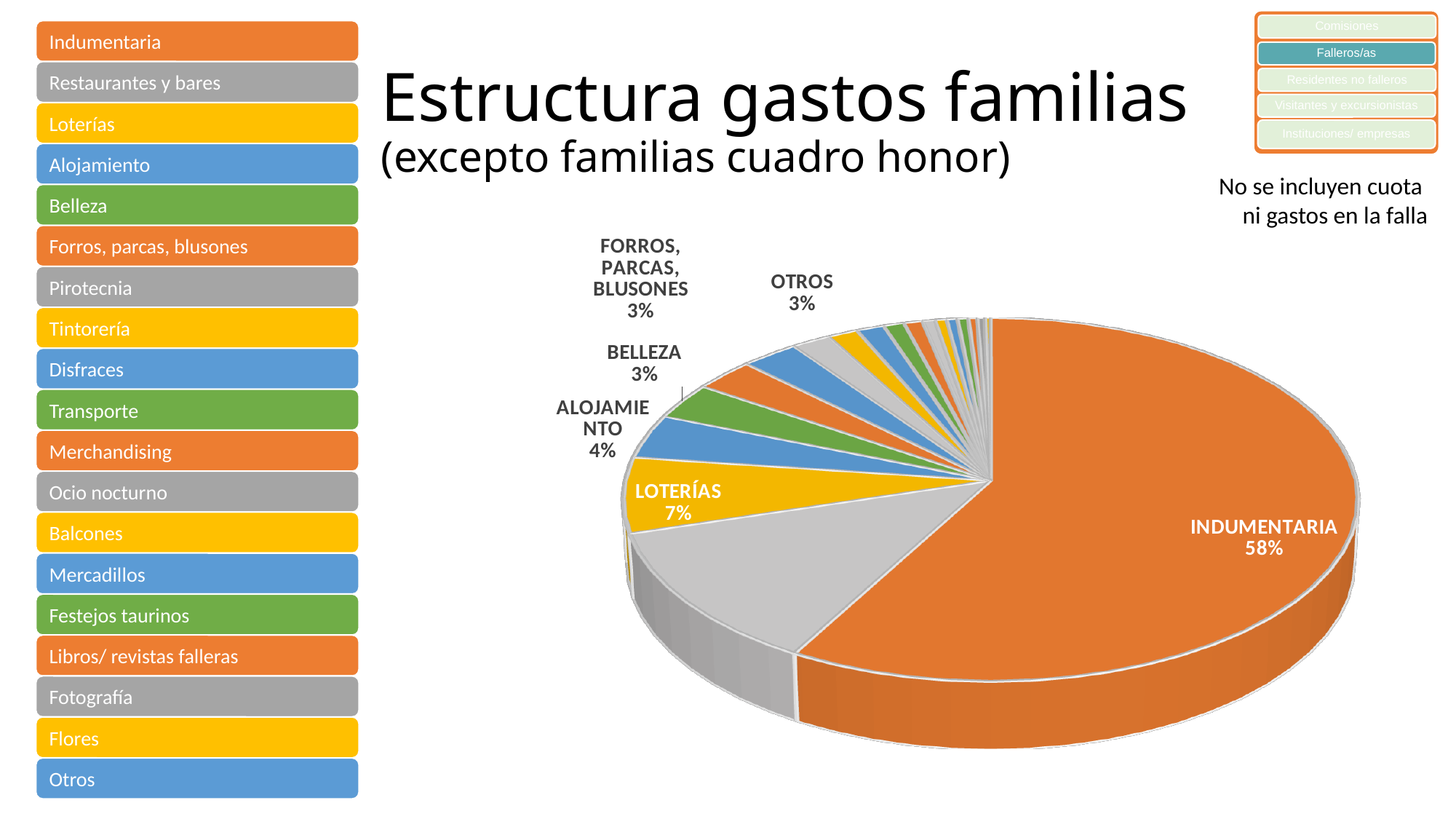
What percentage of family spending does INDUMENTARIA account for? 58% What percentage is shown for FORROS, PARCAS, BLUSONES? 3% Which is larger, the share for LOTERÍAS or the share for ALOJAMIENTO? LOTERÍAS What percentage is shown for ALOJAMIENTO? 4% How many slices of the pie have a percentage label printed? 6 What percentage is shown for BELLEZA? 3% What share of the pie is LOTERÍAS? 7% How many percentage points larger is INDUMENTARIA than LOTERÍAS? 51 What is the main title of the slide? Estructura gastos familias What kind of chart is shown on the slide? Pie chart What percentage is shown for OTROS? 3% Which category has the largest slice of the pie? INDUMENTARIA